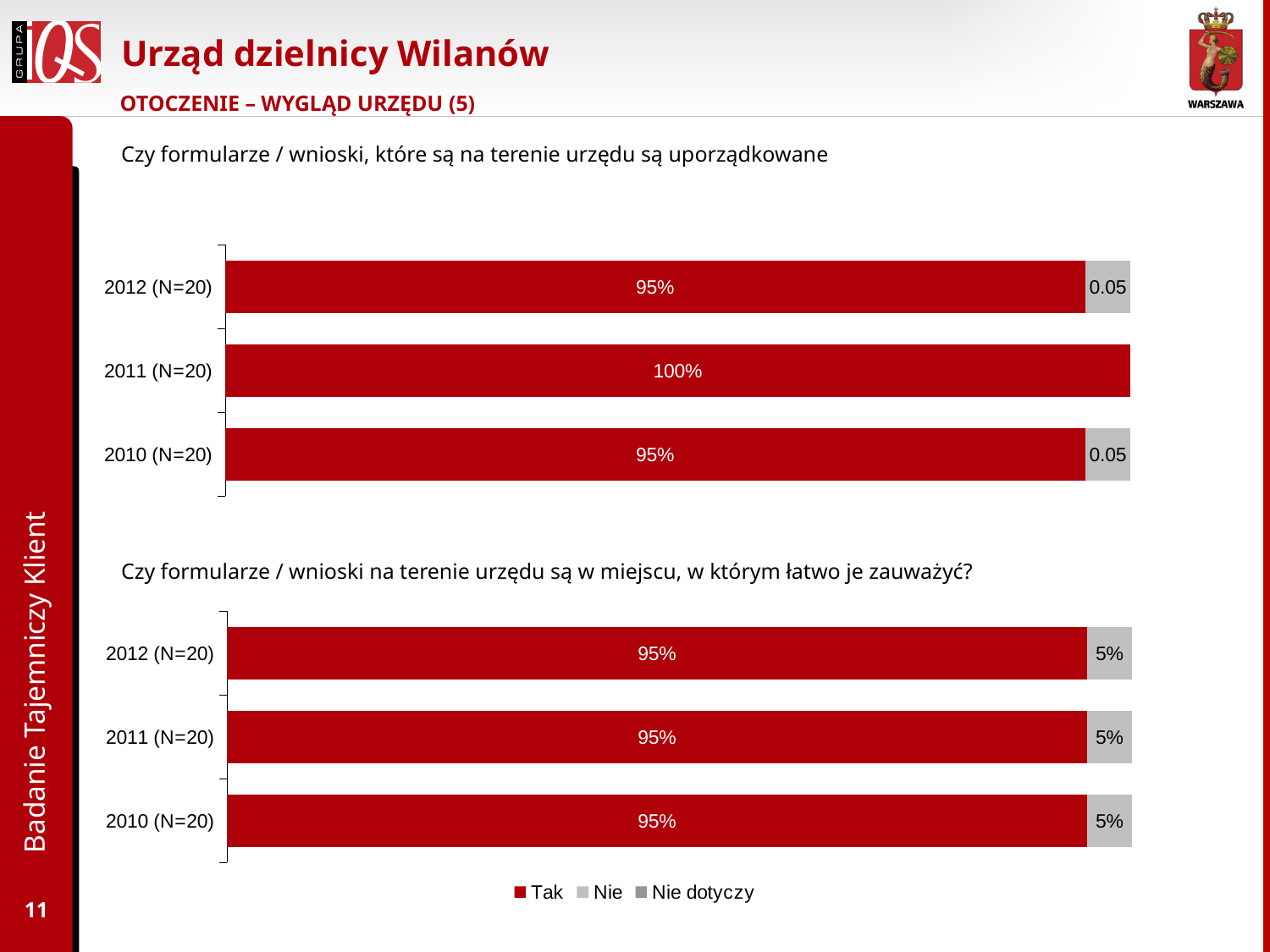
In the top chart ("Czy formularze / wnioski, które są na terenie urzędu są uporządkowane"), what is the "Tak" value for 2012 (N=20)? 95% In the bottom chart ("Czy formularze / wnioski na terenie urzędu są w miejscu, w którym łatwo je zauważyć?"), what is the "Tak" value for 2010 (N=20)? 95% What are the legend entries shown at the bottom of the slide? Tak, Nie, Nie dotyczy How many year categories does the bottom chart ("Czy formularze / wnioski na terenie urzędu są w miejscu, w którym łatwo je zauważyć?") show? 3 In the top chart ("Czy formularze / wnioski, które są na terenie urzędu są uporządkowane"), which year has the highest "Tak" value? 2011 (N=20) In the top chart ("Czy formularze / wnioski, które są na terenie urzędu są uporządkowane"), what label is shown on the grey "Nie" segment for 2010 (N=20)? 0.05 In the top chart ("Czy formularze / wnioski, które są na terenie urzędu są uporządkowane"), what is the difference between the "Tak" value for 2011 (N=20) and for 2012 (N=20)? 5% In the bottom chart ("Czy formularze / wnioski na terenie urzędu są w miejscu, w którym łatwo je zauważyć?"), what is the "Nie" value for 2012 (N=20)? 5% In the top chart ("Czy formularze / wnioski, które są na terenie urzędu są uporządkowane"), what is the "Tak" value for 2011 (N=20)? 100% What type of chart is the top chart ("Czy formularze / wnioski, które są na terenie urzędu są uporządkowane")? Stacked horizontal bar chart How many series does the legend at the bottom of the slide list? 3 In the bottom chart ("Czy formularze / wnioski na terenie urzędu są w miejscu, w którym łatwo je zauważyć?"), what is the total of the "Tak" and "Nie" segments for 2011 (N=20)? 100%